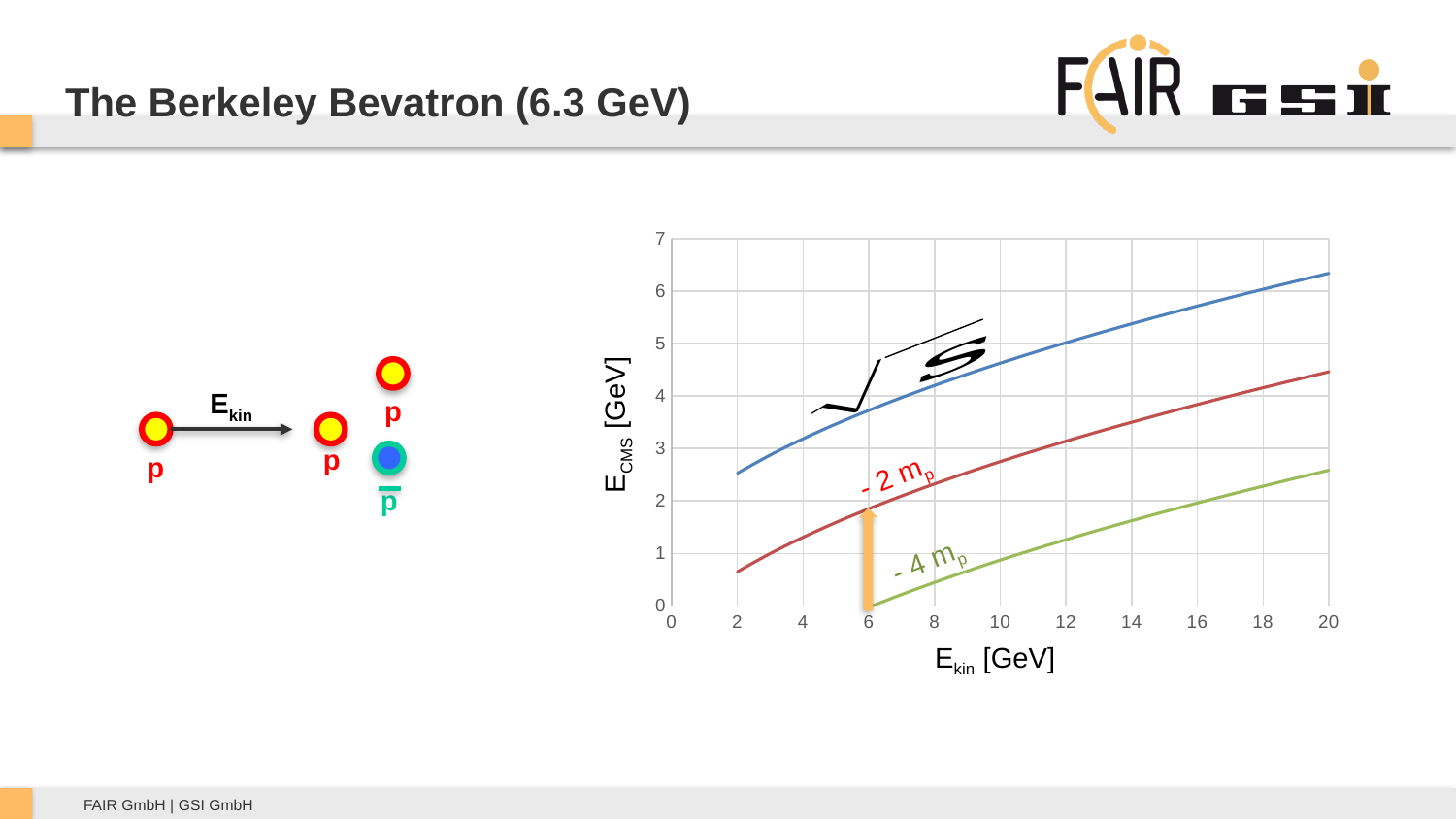
What is the label of the x axis of the chart? E_kin [GeV] Which curve has the lowest values across the plotted range? green (- 4 m_p) What kind of chart is shown on the slide? line chart At E_kin = 10 GeV, which curve has the higher value, the blue (√s) curve or the green (- 4 m_p) curve? blue (√s) Is the value of the green (- 4 m_p) curve at E_kin = 20 GeV greater or less than 3? less Is the value of the blue (√s) curve at E_kin = 2 GeV greater or less than 2? greater Is the value of the red (- 2 m_p) curve at E_kin = 2 GeV greater or less than 1? less How many curves are plotted on the chart? 3 What is the label of the y axis of the chart? E_CMS [GeV] Do the curves rise or fall as E_kin increases? rise